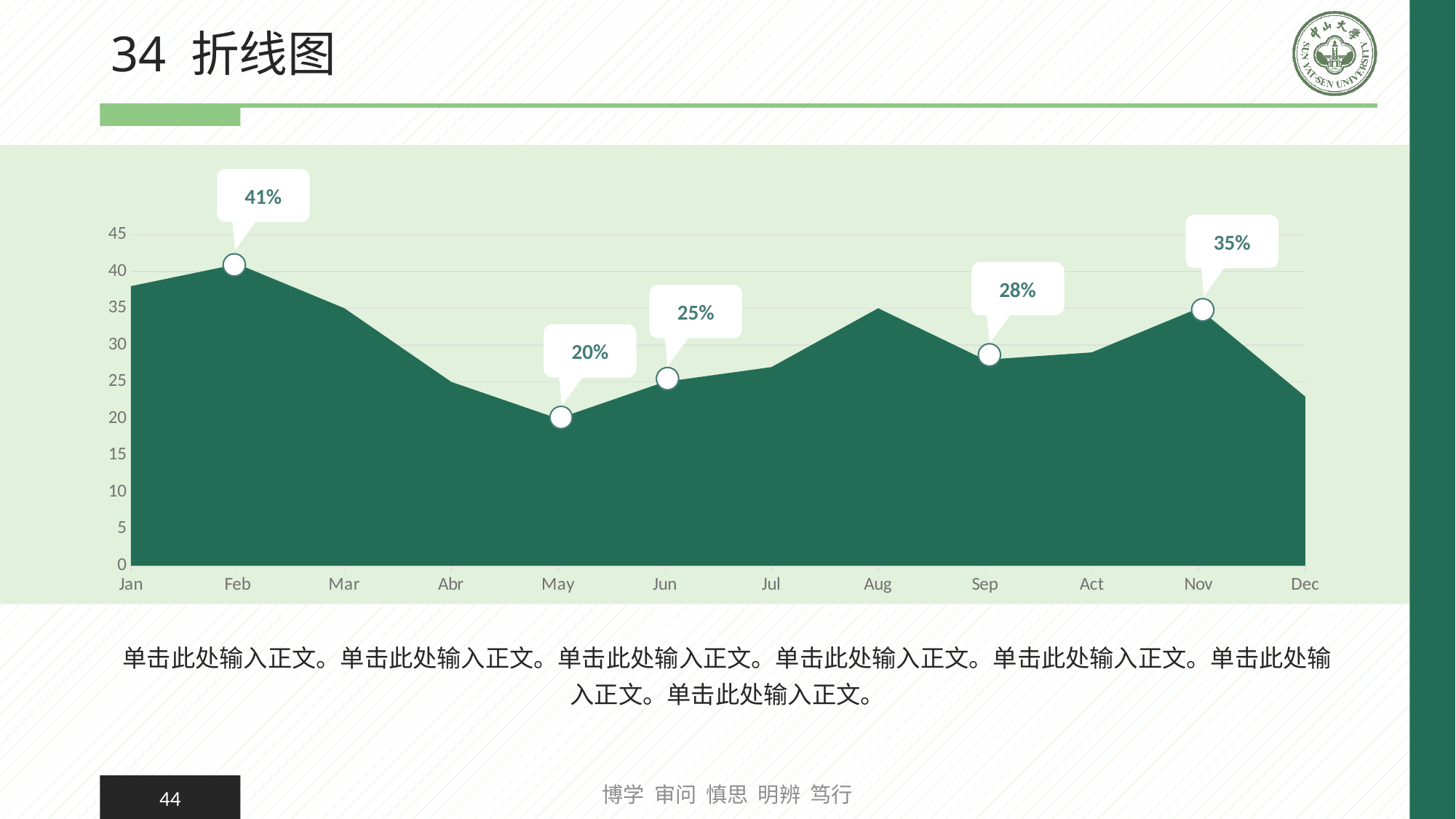
Which is larger, the value for Nov or the value for Sep? Nov What is the difference between the values for Feb and May? 21 percentage points How many months are shown on the x axis? 12 What is the value for Feb? 41% What is the value for May? 20% Is the value for Jan greater or less than 35? greater What is the value for Sep? 28% Which month has the highest value? Feb What is the value for Jun? 25% Which month has the lowest value? May What is the value for Nov? 35% Is the value for Dec greater or less than 25? less